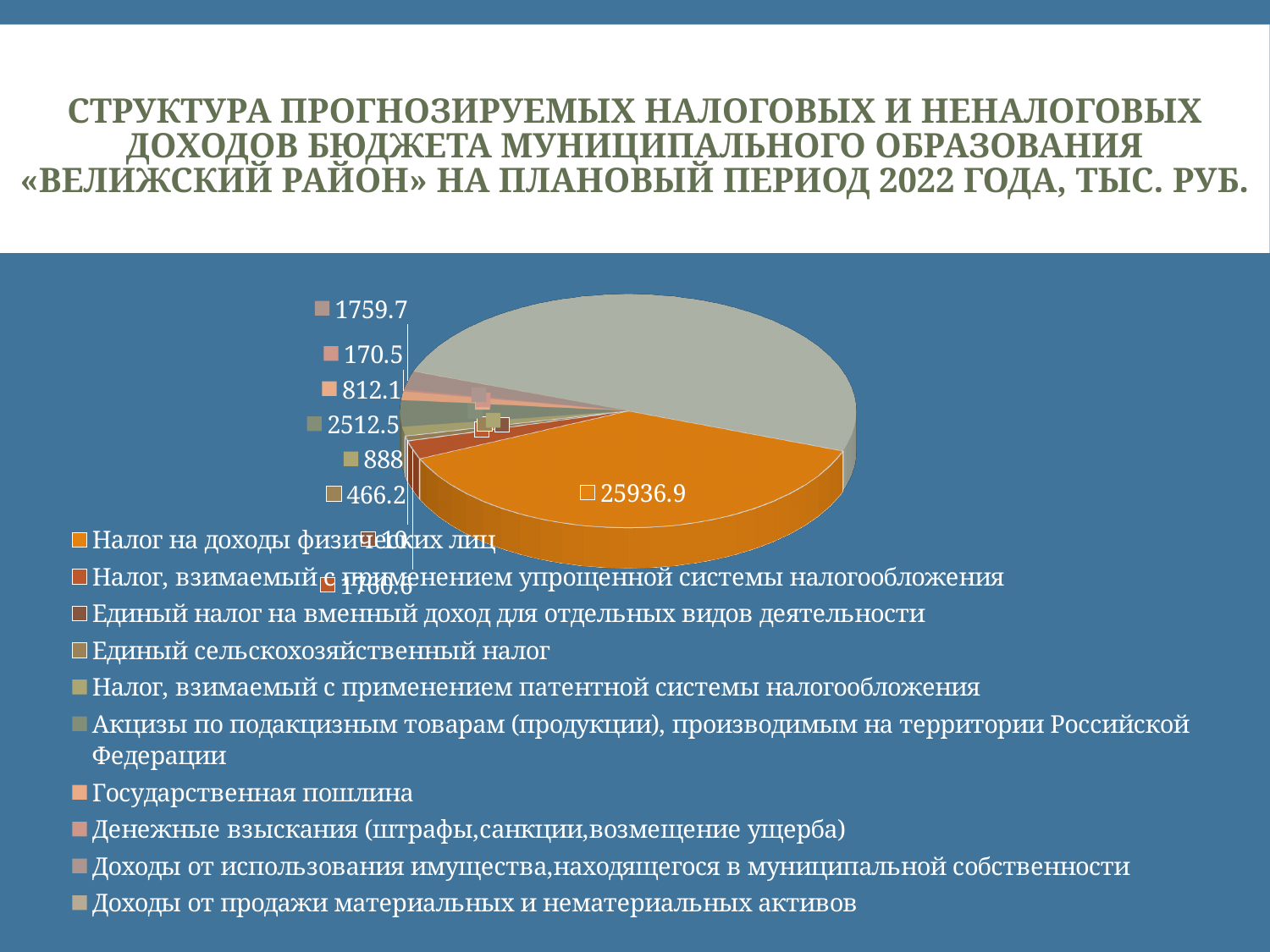
How many categories does the legend list? 10 What is the value shown for Налог, взимаемый с применением патентной системы налогообложения? 888 What is the value shown for Денежные взыскания (штрафы,санкции,возмещение ущерба)? 170.5 What is the difference between the values for Акцизы по подакцизным товарам (2512.5) and Налог, взимаемый с применением патентной системы налогообложения (888)? 1624.5 What is the value shown for Акцизы по подакцизным товарам (продукции), производимым на территории Российской Федерации? 2512.5 Which is larger: Акцизы по подакцизным товарам or Налог, взимаемый с применением патентной системы налогообложения? Акцизы по подакцизным товарам What colour is the slice for Налог на доходы физических лиц? orange Which category has the largest slice of the pie? Налог на доходы физических лиц What is the value shown for Государственная пошлина? 812.1 What is the value shown for Налог на доходы физических лиц? 25936.9 In what units are the values on the chart expressed, according to the slide title? тыс. руб. What kind of chart is shown on the slide? pie chart